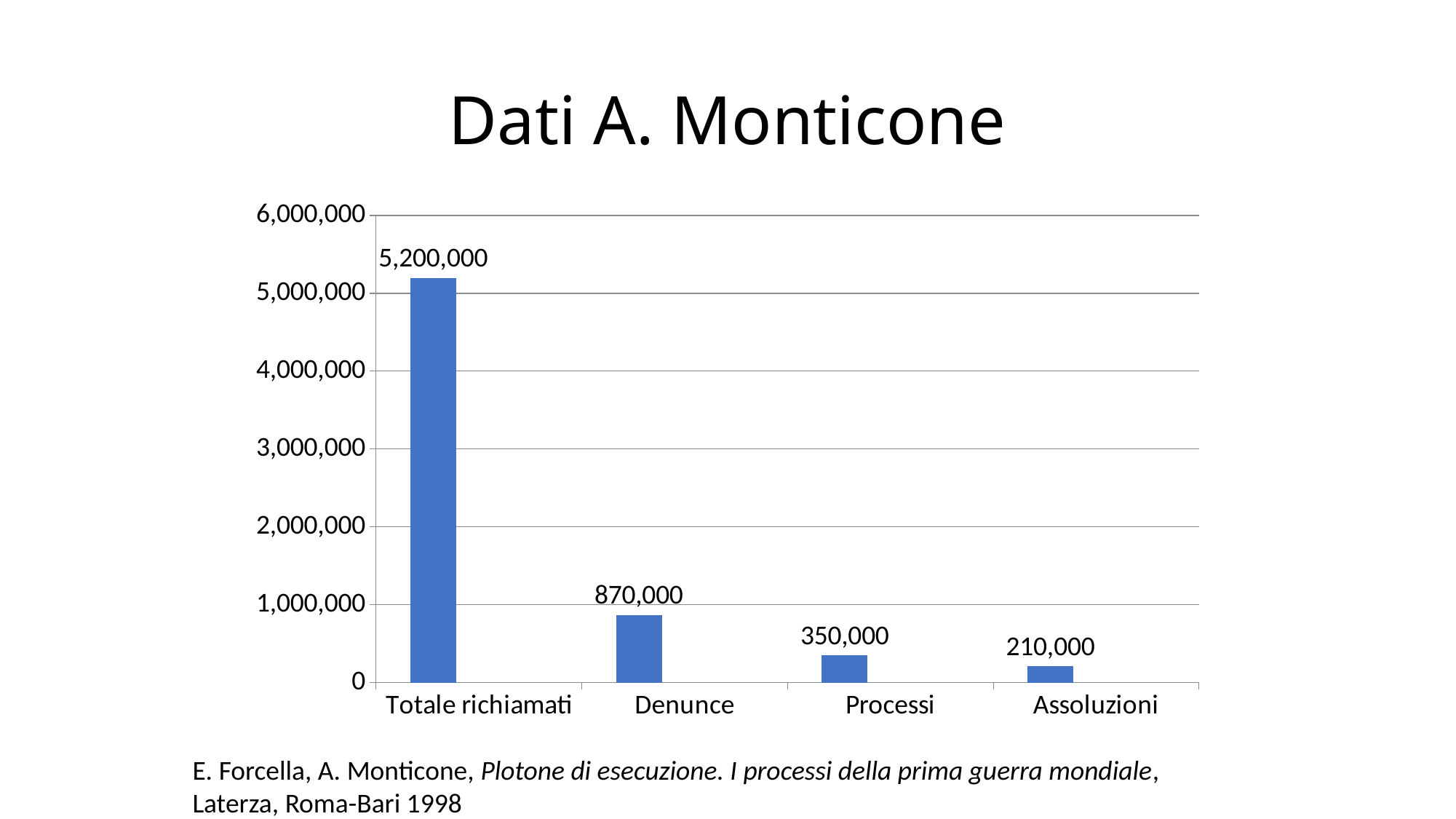
What is the value for Totale richiamati? 5,200,000 How many categories are shown on the x axis? 4 Do the values rise or fall from left to right along the x axis? Fall Which category has the lowest value? Assoluzioni Which category has the highest value? Totale richiamati What is the value for Processi? 350,000 What is the value for Denunce? 870,000 Which is larger, the value for Denunce or the value for Processi? Denunce What kind of chart is shown on the slide? Bar chart What is the value for Assoluzioni? 210,000 What is the difference between the values for Denunce and Processi? 520,000 What is the difference between the values for Processi and Assoluzioni? 140,000